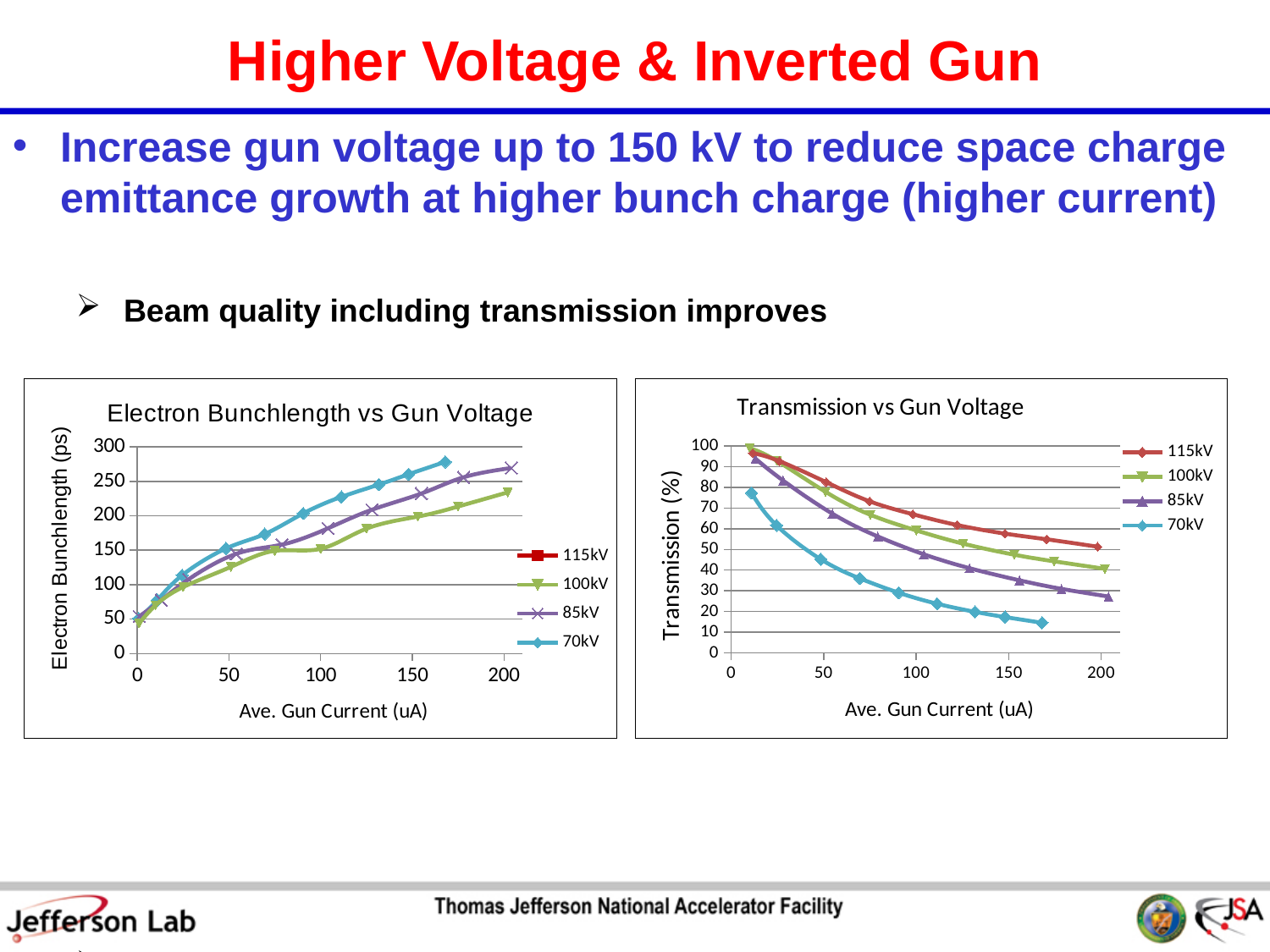
How many series does the legend of the 'Transmission vs Gun Voltage' chart list? 4 In the 'Transmission vs Gun Voltage' chart, which series has the lowest transmission at 100 uA? 70kV In the 'Electron Bunchlength vs Gun Voltage' chart, at 150 uA, which series has the larger bunchlength: 70kV or 100kV? 70kV What is the x-axis label of the 'Transmission vs Gun Voltage' chart? Ave. Gun Current (uA) In the 'Transmission vs Gun Voltage' chart, is the 115kV transmission at 100 uA greater or less than 60? greater In the 'Transmission vs Gun Voltage' chart, do the transmission values rise or fall as average gun current increases? fall What type of chart is the 'Electron Bunchlength vs Gun Voltage' chart? line chart In the 'Electron Bunchlength vs Gun Voltage' chart, is the 100kV bunchlength at 200 uA greater or less than 200? greater In the 'Electron Bunchlength vs Gun Voltage' chart, do the bunchlength values rise or fall as average gun current increases? rise What is the y-axis label of the 'Electron Bunchlength vs Gun Voltage' chart? Electron Bunchlength (ps) In the 'Transmission vs Gun Voltage' chart, which series has the highest transmission at 150 uA? 115kV